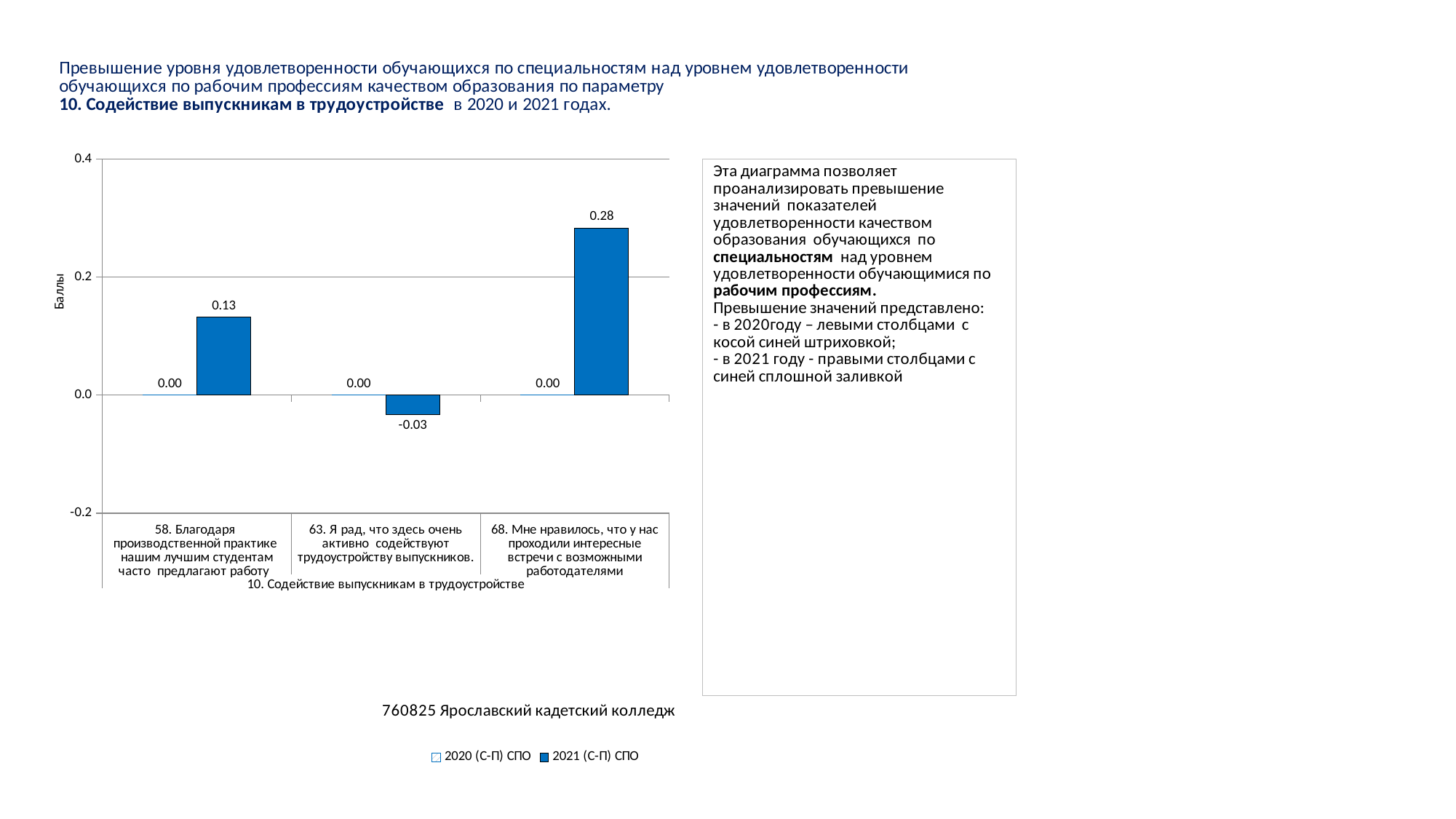
What is the label of the vertical axis of the chart? Баллы What kind of chart is shown on the slide? Bar chart Which category has the highest value for 2021 (С-П) СПО? 68. Мне нравилось, что у нас проходили интересные встречи с возможными работодателями Which is larger for 2021 (С-П) СПО: the value for category 58 or the value for category 63? Category 58 What is the value for 2021 (С-П) СПО for category 63 (Я рад, что здесь очень активно содействуют трудоустройству выпускников)? -0.03 What is the value for 2020 (С-П) СПО for category 58? 0.00 How many series does the chart legend list? 2 Which category has the lowest value for 2021 (С-П) СПО? 63. Я рад, что здесь очень активно содействуют трудоустройству выпускников. How many categories are shown on the x axis of the chart? 3 What is the value for 2021 (С-П) СПО for category 58 (Благодаря производственной практике нашим лучшим студентам часто предлагают работу)? 0.13 What is the value for 2021 (С-П) СПО for category 68 (Мне нравилось, что у нас проходили интересные встречи с возможными работодателями)? 0.28 What is the difference between the 2021 (С-П) СПО values for category 68 and category 58? 0.15